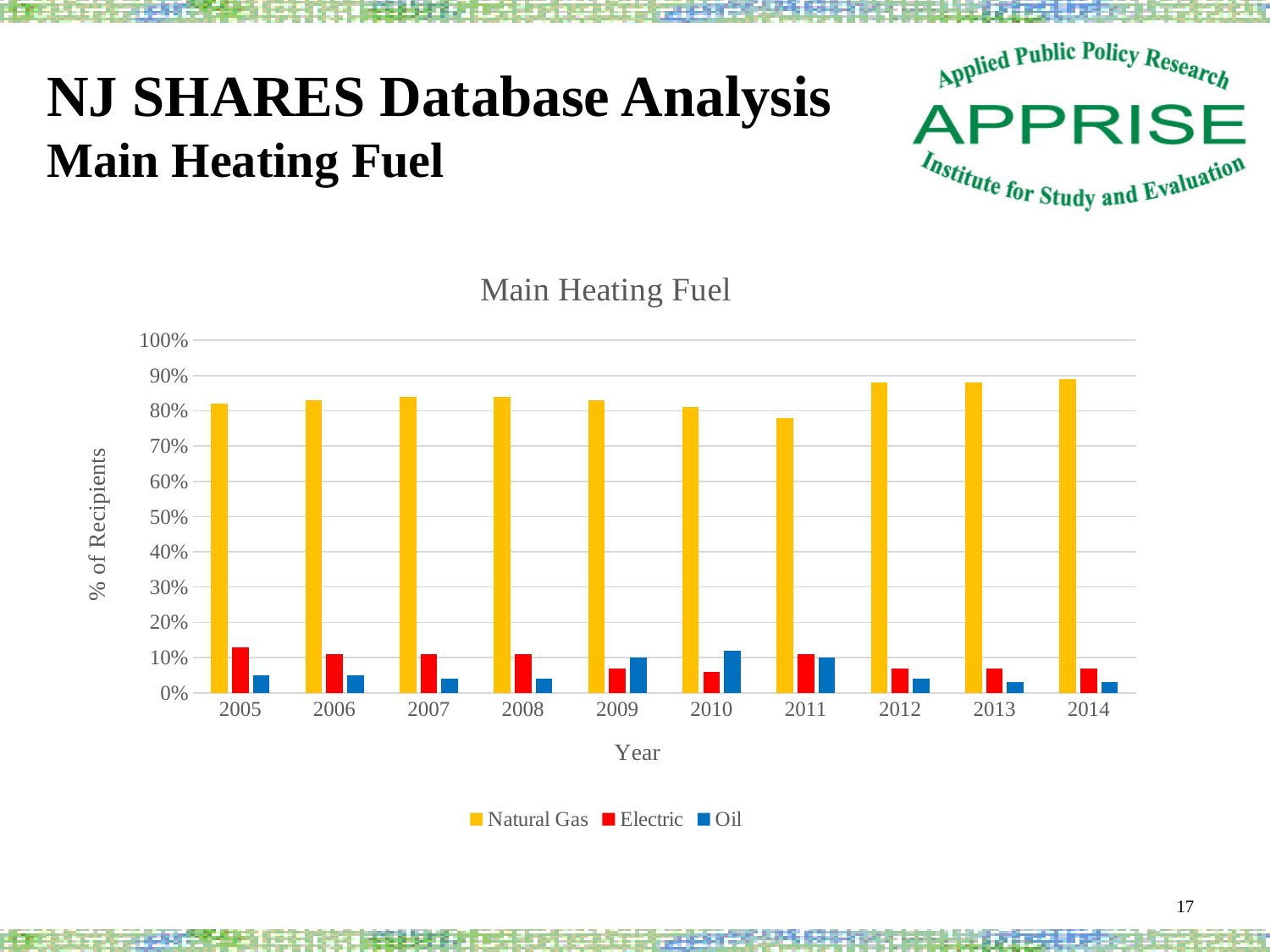
In 2009, which is larger, the Electric value or the Oil value? Oil What kind of chart is shown on the slide? Bar chart Is the Natural Gas value for 2014 greater or less than 80%? greater Is the Natural Gas value for 2011 greater or less than 80%? less In which year is the Natural Gas value lowest? 2011 How many series does the legend list? 3 In 2005, which is larger, the Electric value or the Oil value? Electric In which year is the Oil value highest? 2010 Does the Natural Gas value rise or fall from 2011 to 2014? Rise What is the label on the y axis? % of Recipients Is the Electric value for 2010 greater or less than 10%? less How many years are shown on the x axis? 10